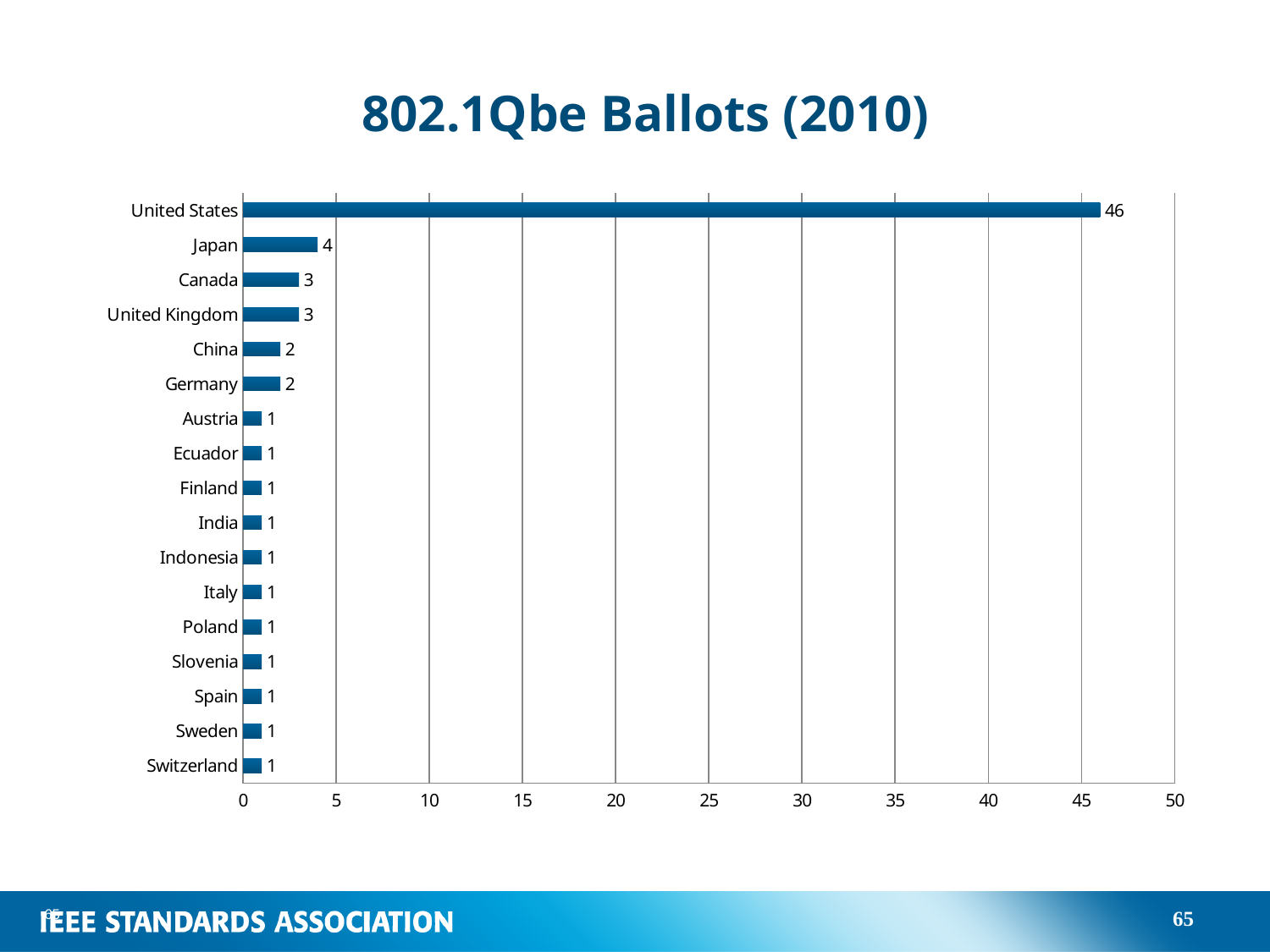
What is the difference between the values for United States and Japan? 42 Is the value for United States greater or less than 45? greater What is the value for Germany? 2 What kind of chart is shown on the slide? bar chart What is the value for Canada? 3 What is the difference between the values for Canada and Austria? 2 Which country has the highest value? United States What is the title of the chart? 802.1Qbe Ballots (2010) Which is larger, the value for Japan or the value for China? Japan What is the value for United States? 46 How many countries are shown in the chart? 17 What is the value for Japan? 4